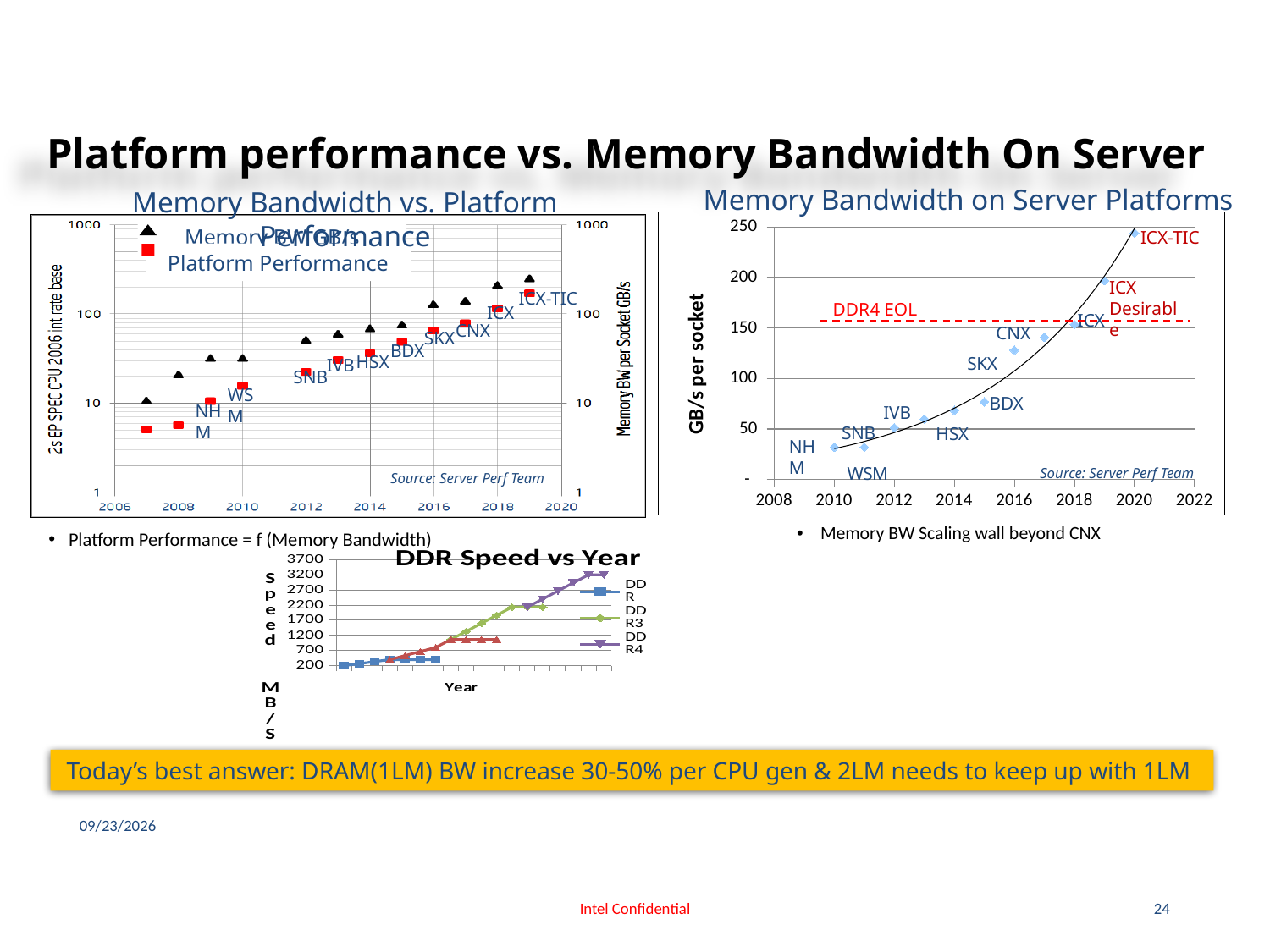
In the 'Memory Bandwidth on Server Platforms' chart, which has the higher GB/s per socket, SKX or BDX? SKX What kind of chart is the 'DDR Speed vs Year' chart? line chart How many series does the legend of the 'DDR Speed vs Year' chart list? 3 In the 'Memory Bandwidth on Server Platforms' chart, which platform has the lowest GB/s per socket? NHM and WSM (tied) In the 'Memory Bandwidth on Server Platforms' chart, which platform has the highest GB/s per socket? ICX-TIC How many series does the legend of the 'Memory Bandwidth vs. Platform Performance' chart list? 2 In the 'Memory Bandwidth on Server Platforms' chart, is the value for NHM greater or less than 50 GB/s per socket? less In the 'Memory Bandwidth on Server Platforms' chart, how many labeled platform points are plotted? 11 In the 'Memory Bandwidth on Server Platforms' chart, do the values rise or fall as the year increases? rise In the 'Memory Bandwidth on Server Platforms' chart, what is the label of the red dashed horizontal line? DDR4 EOL In the 'Memory Bandwidth on Server Platforms' chart, is the value for ICX-TIC greater or less than 200 GB/s per socket? greater